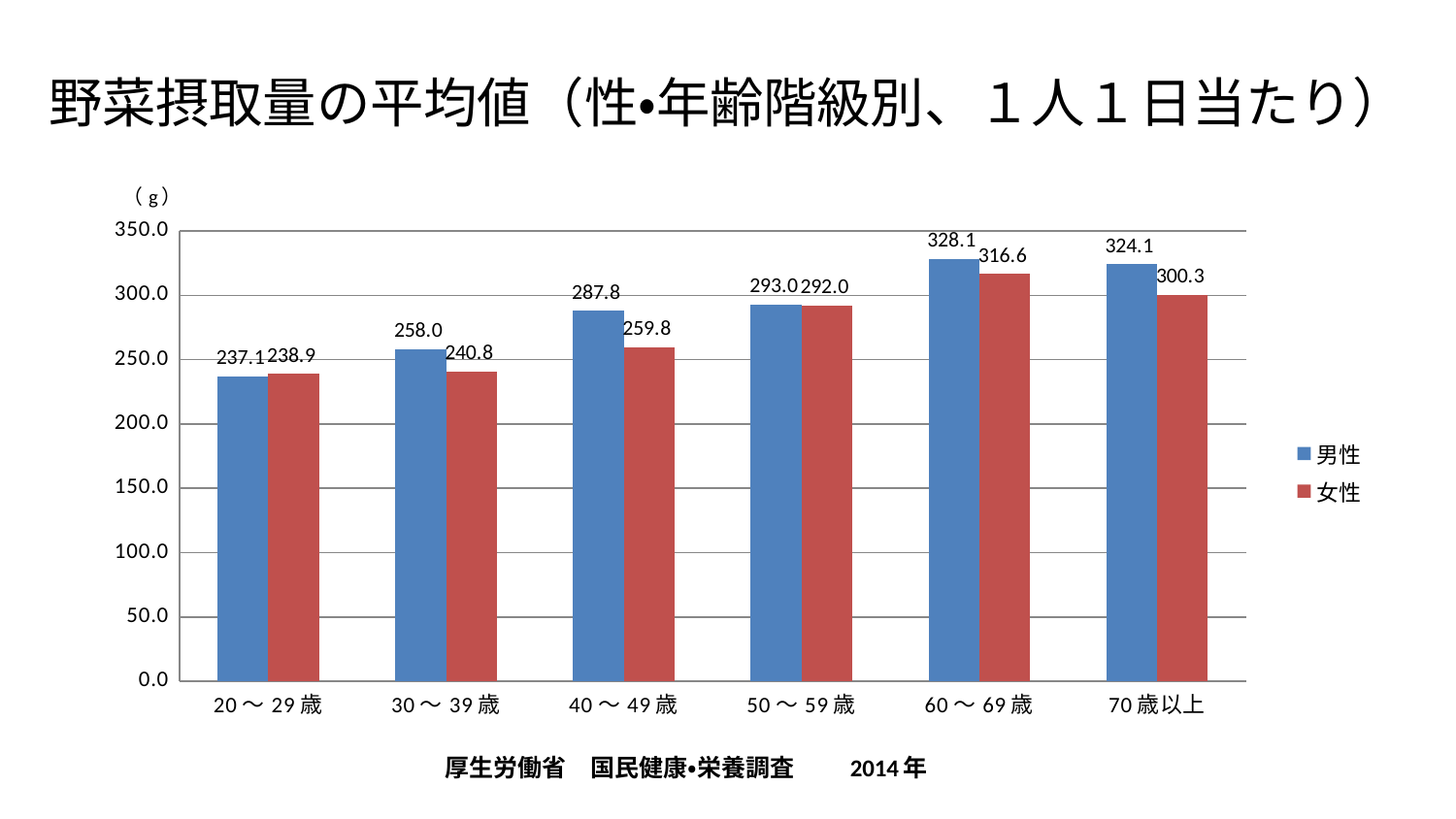
Is the value for 女性 in the 60～69歳 age group greater or less than 300.0? greater Do the 男性 values rise or fall from 20～29歳 to 60～69歳? rise What is the difference between the 男性 and 女性 values in the 40～49歳 age group? 28.0 Which age group has the lowest value for 女性? 20～29歳 Which is larger in the 20～29歳 age group, the 男性 value or the 女性 value? 女性 How many series does the legend list? 2 Which age group has the highest value for 男性? 60～69歳 What unit is shown on the y axis? g What is the value for 女性 in the 70歳以上 age group? 300.3 How many age groups are shown on the x axis? 6 What is the value for 男性 in the 40～49歳 age group? 287.8 What kind of chart is shown on the slide? bar chart